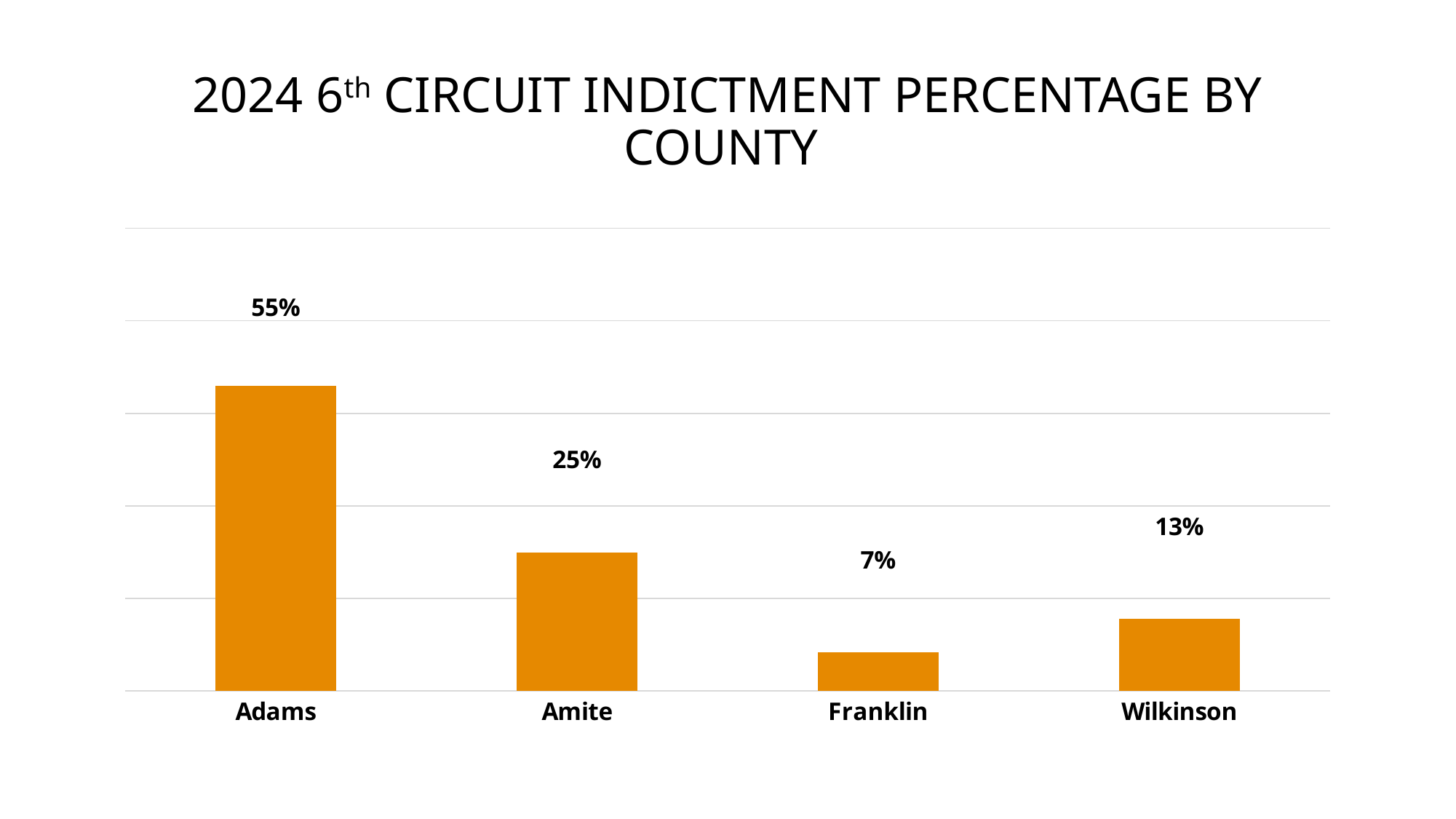
What is the indictment percentage for Franklin? 7% What type of chart is shown on the slide? Bar chart What is the title of the chart? 2024 6th Circuit Indictment Percentage by County What is the difference between the indictment percentages of Adams and Amite? 30% Which county has a higher indictment percentage, Amite or Wilkinson? Amite What is the indictment percentage for Amite? 25% How many counties are shown in the chart? 4 What is the difference between the indictment percentages of Wilkinson and Franklin? 6% Which county has the lowest indictment percentage? Franklin Which county has the highest indictment percentage? Adams What is the indictment percentage for Adams? 55% What is the indictment percentage for Wilkinson? 13%